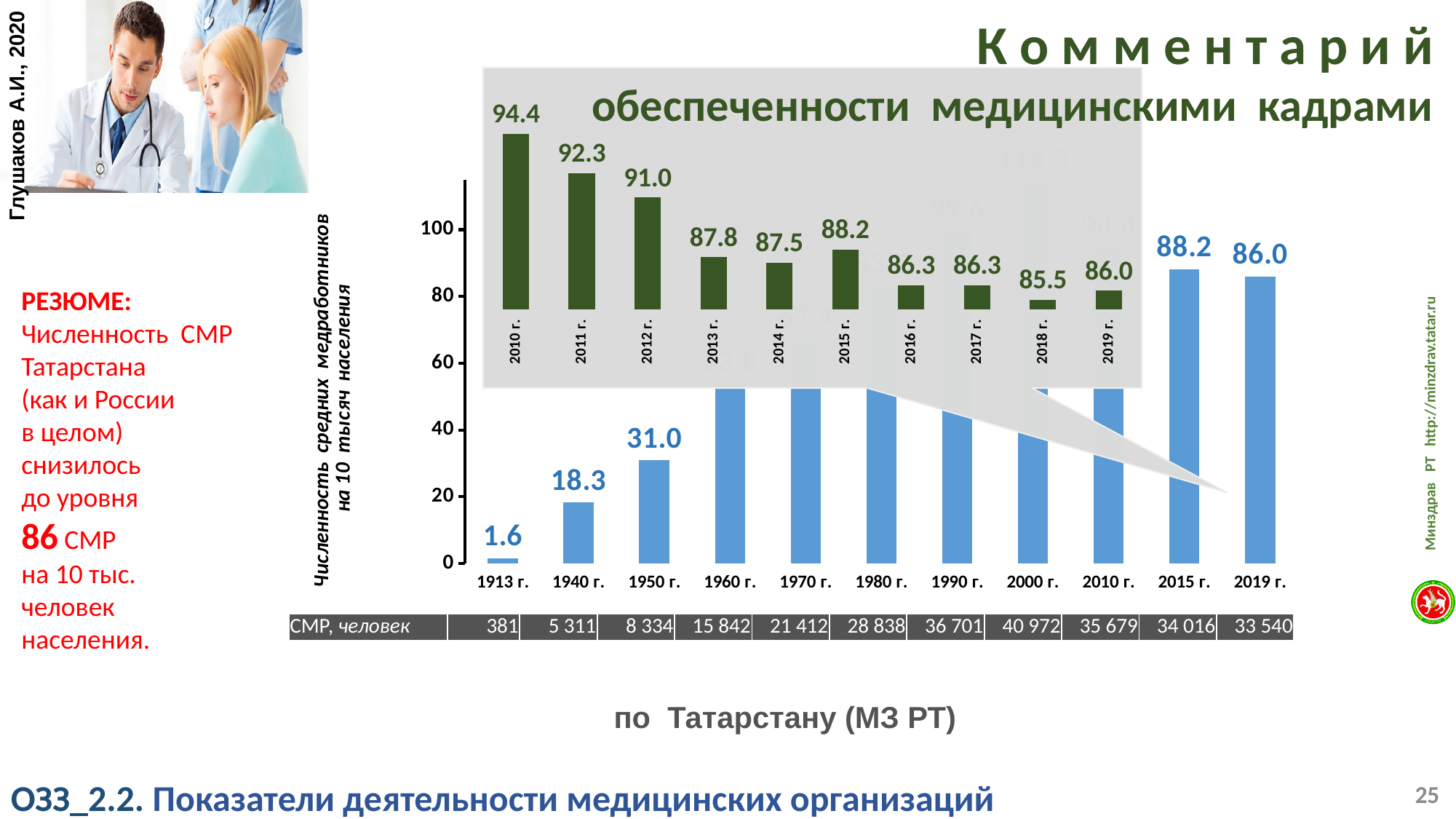
In the inset green bar chart (2010 г.–2019 г.), which year has the highest value? 2010 г. In the main blue bar chart, is the value for 1980 г. greater or less than 40? greater In the inset green bar chart (2010 г.–2019 г.), how many years are plotted? 10 In the inset green bar chart (2010 г.–2019 г.), do the values generally rise or fall from 2010 г. to 2019 г.? fall In the main blue bar chart, which is larger, the value for 2015 г. or the value for 2019 г.? 2015 г. In the main blue bar chart, what is the value for 1913 г.? 1.6 In the inset green bar chart (2010 г.–2019 г.), what is the difference between the values for 2010 г. and 2019 г.? 8.4 In the inset green bar chart (2010 г.–2019 г.), what is the value for 2010 г.? 94.4 In the inset green bar chart (2010 г.–2019 г.), which year has the lowest value? 2018 г. In the table row 'СМР, человек' below the main chart, what is the value for 2000 г.? 40 972 What type of chart is the main chart on the slide? bar chart In the main blue bar chart, what is the value for 1950 г.? 31.0